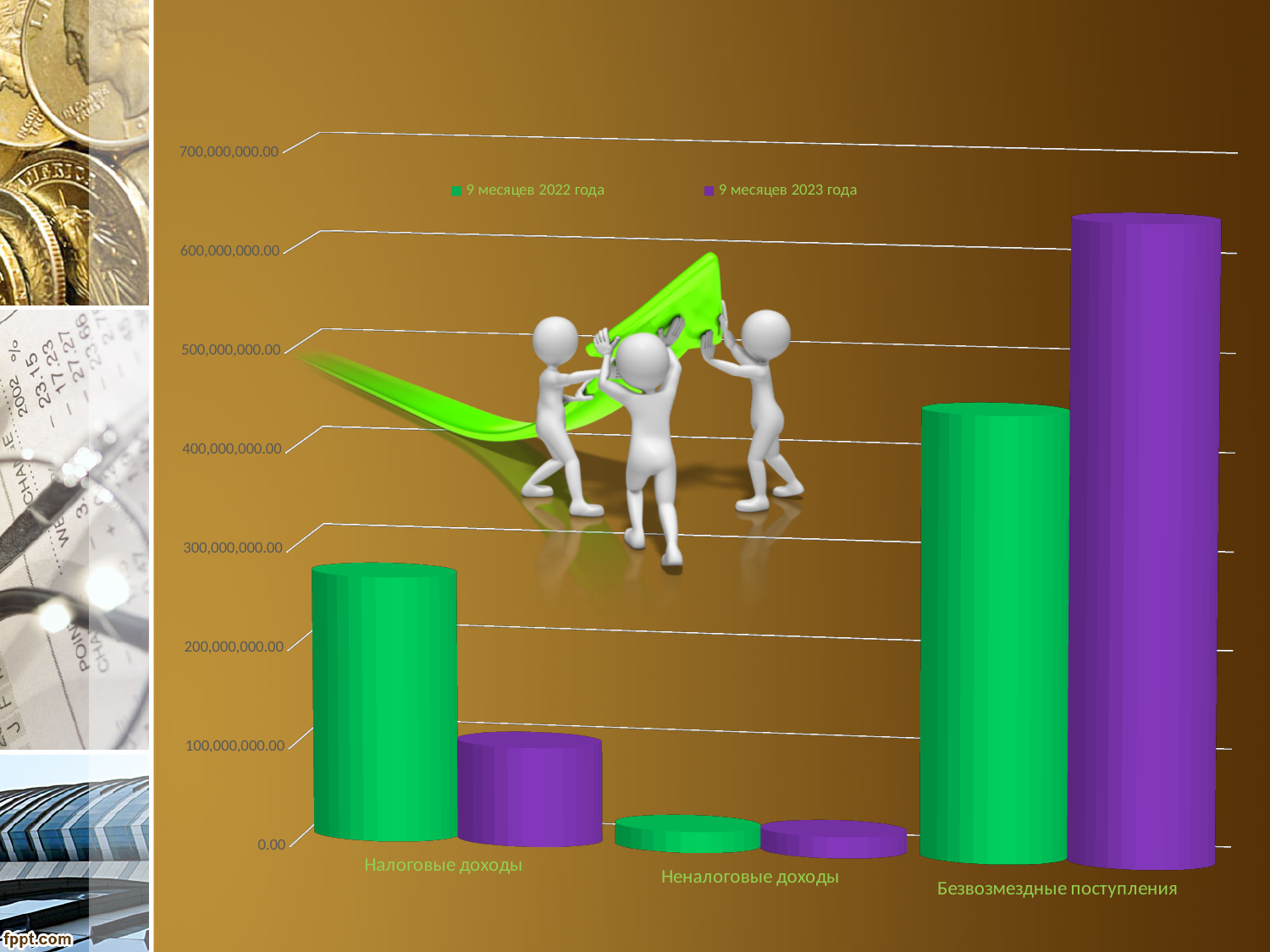
Is the value for Безвозмездные поступления in 9 месяцев 2022 года greater or less than 500,000,000.00? less How many categories are shown on the x axis? 3 For Безвозмездные поступления, which series has the larger value: 9 месяцев 2022 года or 9 месяцев 2023 года? 9 месяцев 2023 года Which colour represents the series 9 месяцев 2023 года in the legend? purple How many series does the legend list? 2 Which category has the highest value for the series 9 месяцев 2023 года? Безвозмездные поступления For Налоговые доходы, which series has the larger value: 9 месяцев 2022 года or 9 месяцев 2023 года? 9 месяцев 2022 года Which category has the lowest value for the series 9 месяцев 2022 года? Неналоговые доходы Is the value for Безвозмездные поступления in 9 месяцев 2023 года greater or less than 600,000,000.00? greater Is the value for Налоговые доходы in 9 месяцев 2022 года greater or less than 200,000,000.00? greater What kind of chart is shown on the slide? bar chart